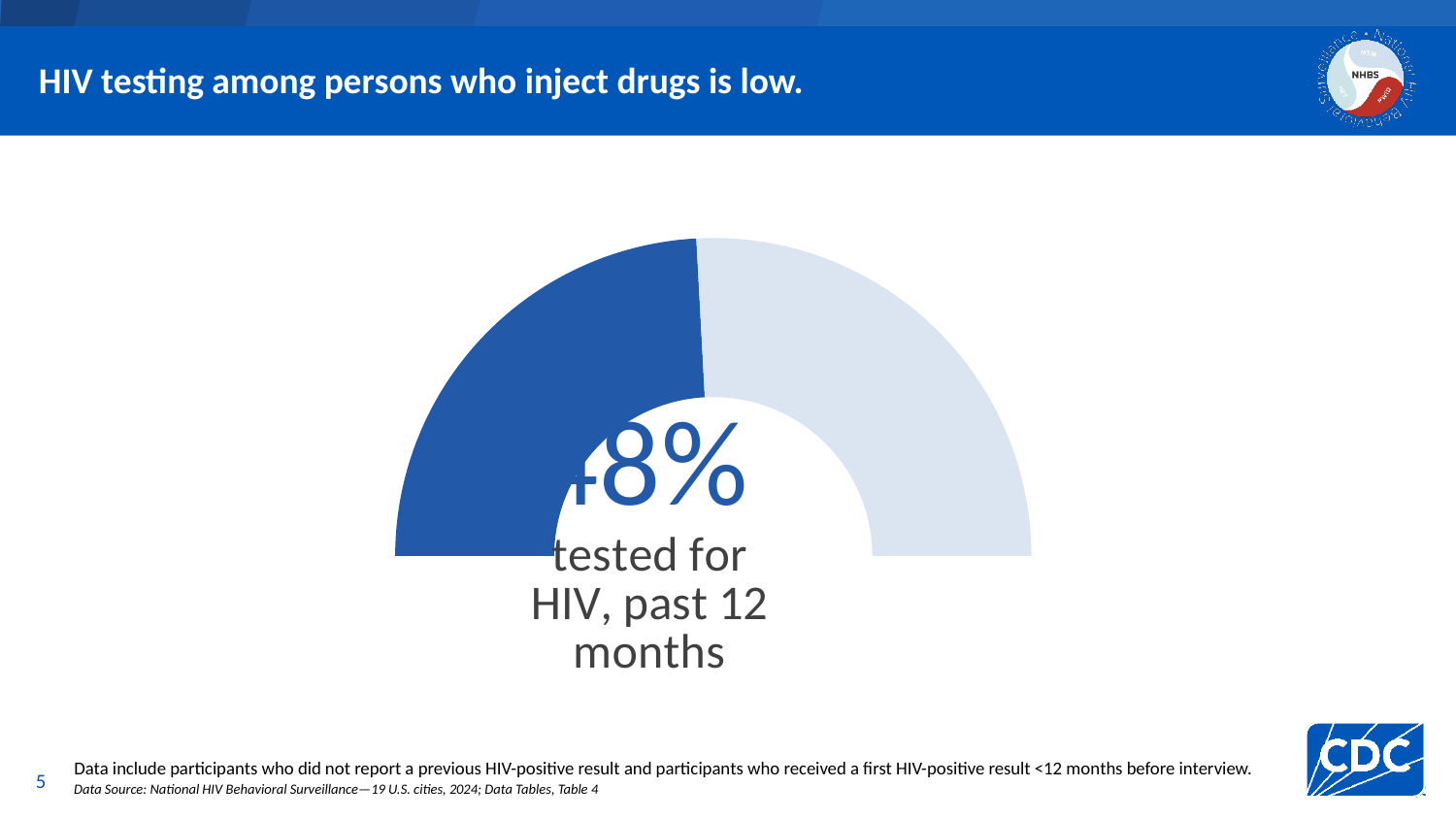
What does the label inside the gauge say the 48% represents? tested for HIV, past 12 months What is the title of the slide containing the gauge chart? HIV testing among persons who inject drugs is low. What share of the gauge is not filled, i.e., the percentage not tested for HIV in the past 12 months? 52% What kind of chart is shown on the slide? A semicircular gauge (donut) chart Which colour is used for the filled (tested) portion of the gauge? Dark blue What percentage of persons who inject drugs were tested for HIV in the past 12 months, according to the chart? 48% Is the filled portion of the gauge larger or smaller than the unfilled portion? smaller How many segments does the gauge chart have? 2 Is the percentage tested for HIV in the past 12 months greater or less than 50%? less